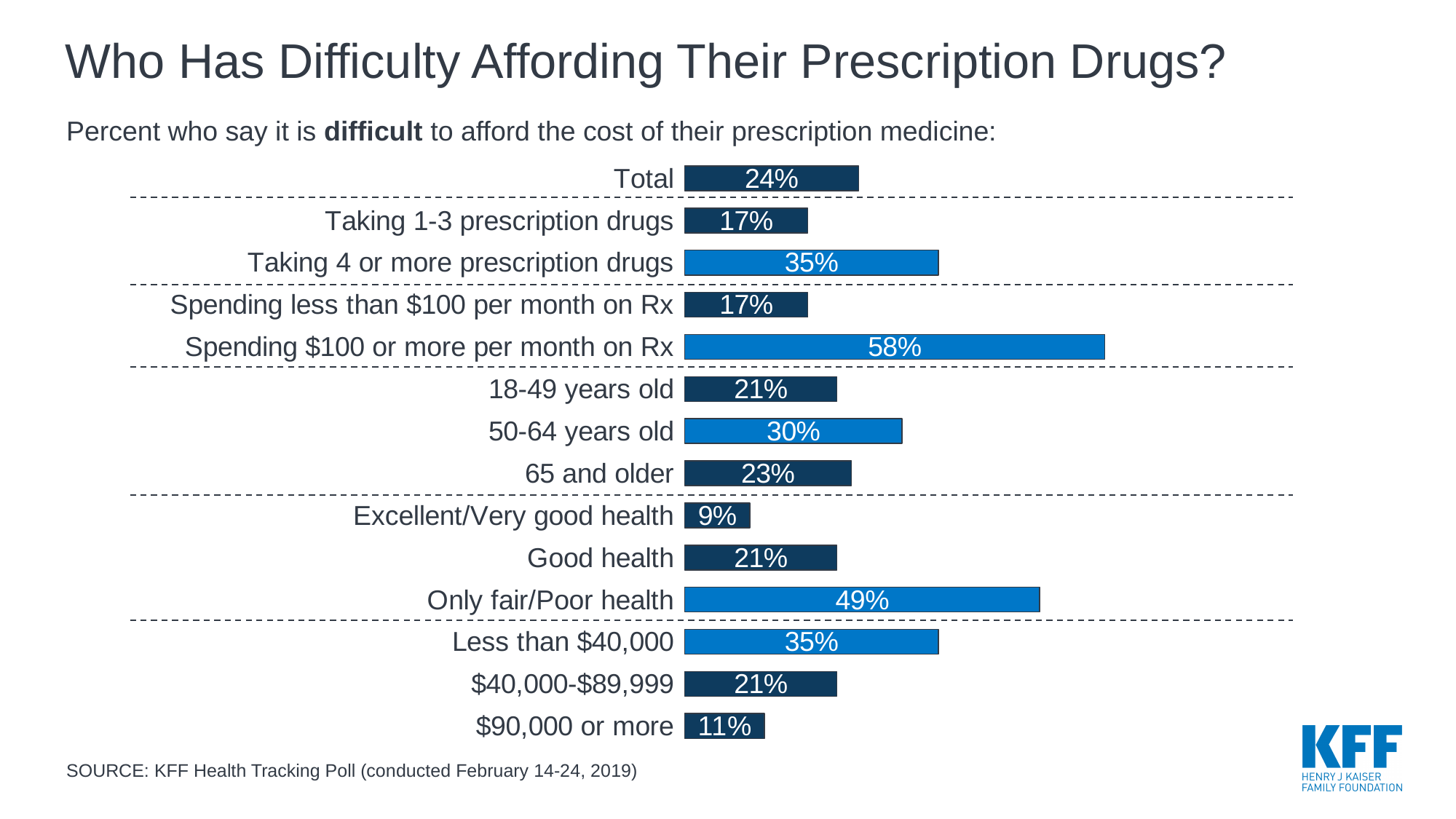
What is the difference between the values for Taking 4 or more prescription drugs and Taking 1-3 prescription drugs? 18 percentage points What is the difference between the values for Only fair/Poor health and Good health? 28 percentage points What is the value for people in Excellent/Very good health? 9% What kind of chart is shown on the slide? Bar chart Which category has the lowest percent saying it is difficult to afford their prescription medicine? Excellent/Very good health What percent of the Total say it is difficult to afford the cost of their prescription medicine? 24% What is the value for those with income of $90,000 or more? 11% Which category has the highest percent saying it is difficult to afford their prescription medicine? Spending $100 or more per month on Rx Which is larger, the value for 50-64 years old or the value for 65 and older? 50-64 years old What is the value for those spending $100 or more per month on Rx? 58% How many categories (bars) are shown in the chart? 14 What is the source cited for the chart? KFF Health Tracking Poll (conducted February 14-24, 2019)